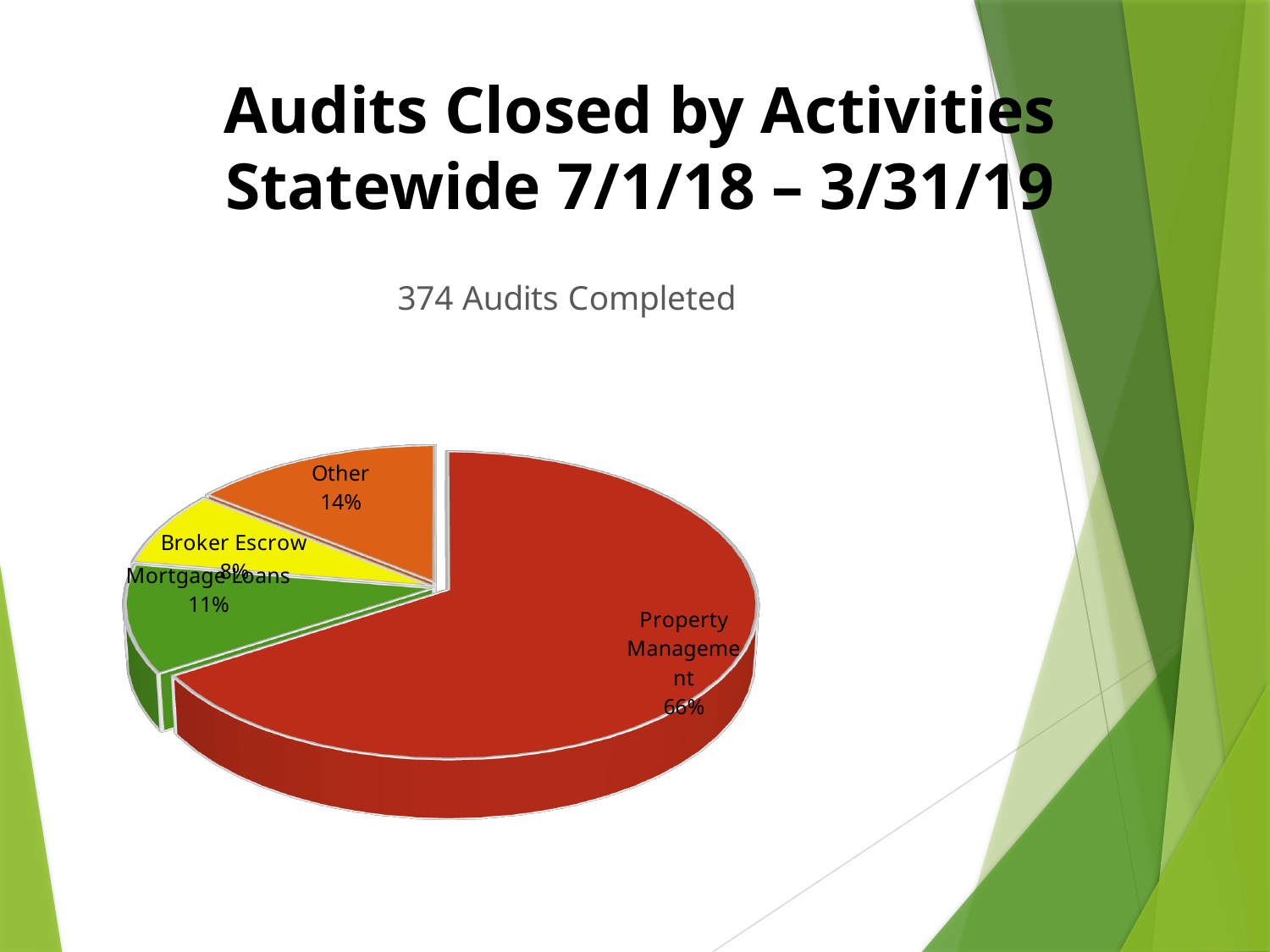
Which activity has the smallest share of audits closed? Broker Escrow Which is larger, the share for Other or the share for Mortgage Loans? Other What kind of chart is shown on the slide? pie chart What share of audits closed is Mortgage Loans? 11% What share of audits closed is Property Management? 66% How many audits were completed in total according to the slide? 374 How many slices does the pie chart have? 4 What share of audits closed is Other? 14% What colour is the Property Management slice? red Which activity has the largest share of audits closed? Property Management What is the difference in percentage points between Property Management and Other? 52 What share of audits closed is Broker Escrow? 8%